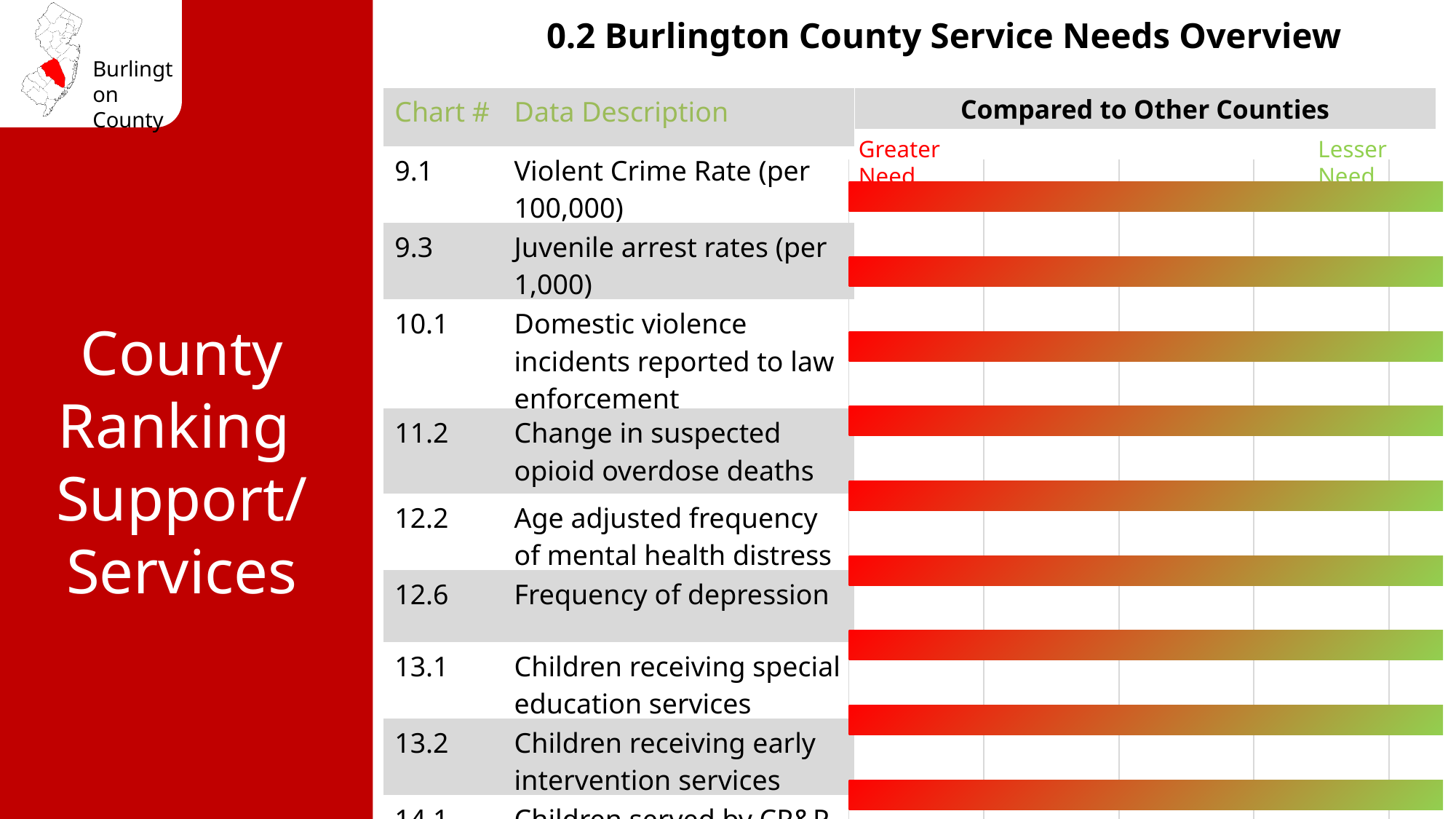
Which data description is listed for chart # 12.6? Frequency of depression What label appears at the left end of the 'Compared to Other Counties' scale? Greater Need Which chart # is listed for 'Juvenile arrest rates (per 1,000)'? 9.3 What is the title of the slide's chart overview? 0.2 Burlington County Service Needs Overview What kind of chart is shown under 'Compared to Other Counties'? bar chart